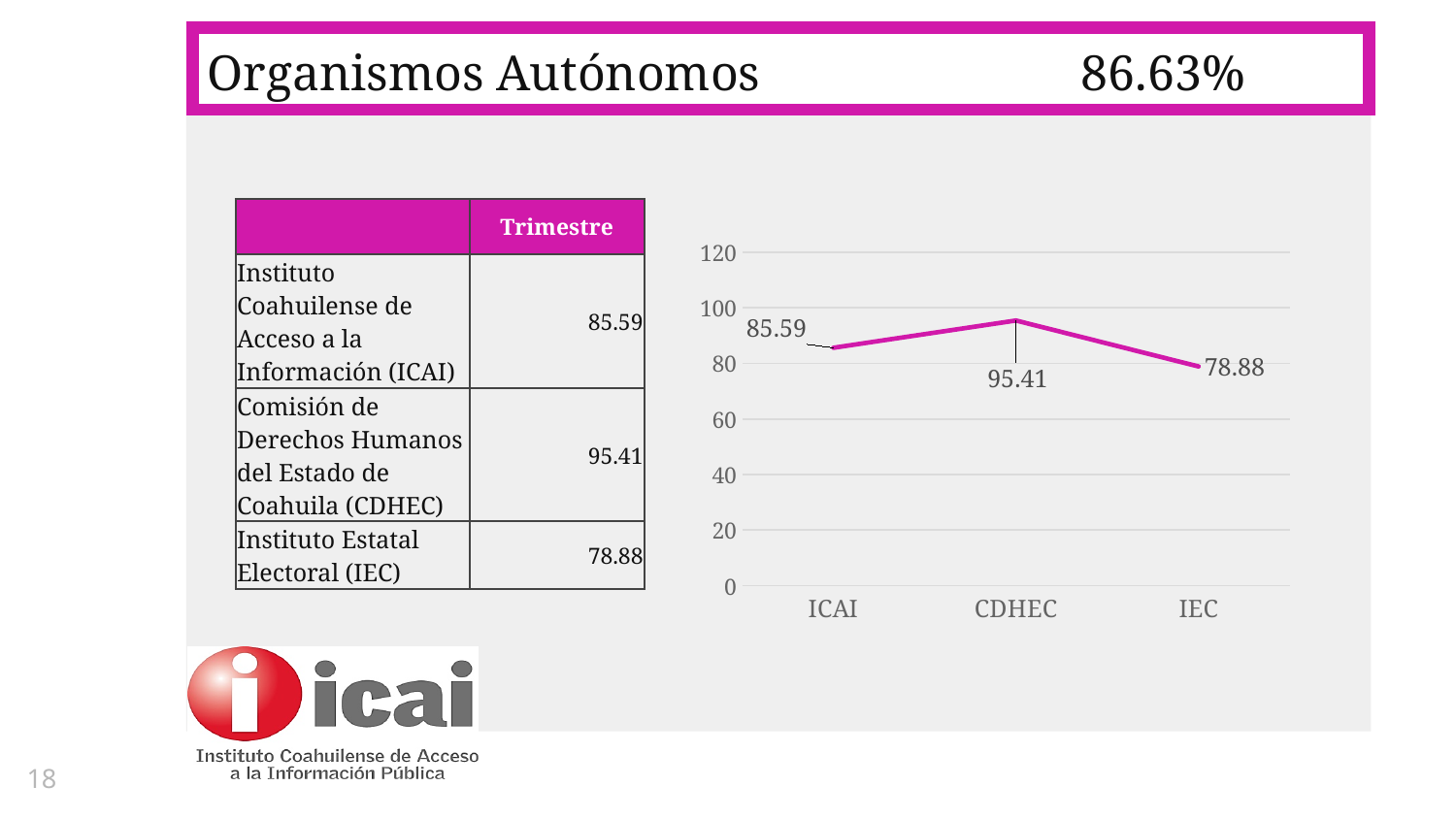
What is the difference between the values for CDHEC and IEC? 16.53 Which is larger, the value for ICAI or the value for IEC? ICAI How many categories are plotted in the chart? 3 Which category has the highest value in the chart? CDHEC What is the maximum value shown on the chart's vertical axis? 120 Is the value for IEC greater or less than 80? less What is the value for CDHEC in the chart? 95.41 What kind of chart is shown on the slide? line chart What is the difference between the values for CDHEC and ICAI? 9.82 What is the value for ICAI in the chart? 85.59 What is the value for IEC in the chart? 78.88 Which category has the lowest value in the chart? IEC